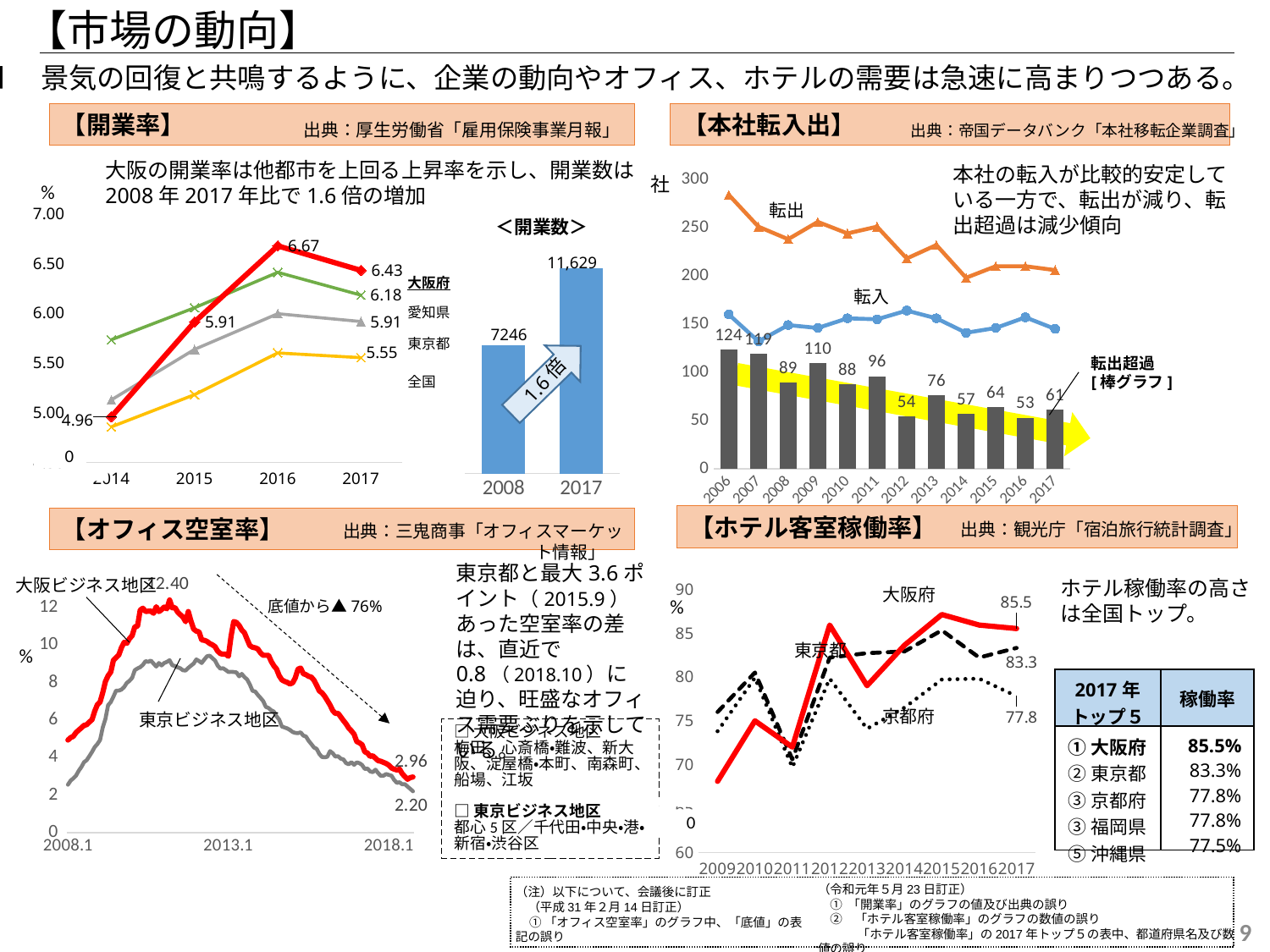
In the 【本社転入出】 chart, what is the difference between the 転出超過 values for 2006 and 2017? 63 In the 【本社転入出】 chart, which year has the lowest 転出超過 bar value? 2016 In the 【本社転入出】 chart, how many years are shown on the x axis? 12 In the 【本社転入出】 chart, what is the 転出超過 bar value for 2006? 124 In the 【開業率】 chart, what is the value for 大阪府 in 2017? 6.43 What kind of chart is the <開業数> chart? bar chart In the 【ホテル客室稼働率】 chart, what is the value for 大阪府 in 2017? 85.5 In the 【開業率】 chart, which series has the highest value in 2017? 大阪府 In the <開業数> bar chart, what is the value for 2017? 11,629 In the 【ホテル客室稼働率】 chart, what is the difference between the 2017 values for 大阪府 and 京都府? 7.7 In the 【本社転入出】 chart, is the 転出 value for 2006 greater or less than 250? greater In the <開業数> bar chart, what is the value for 2008? 7246